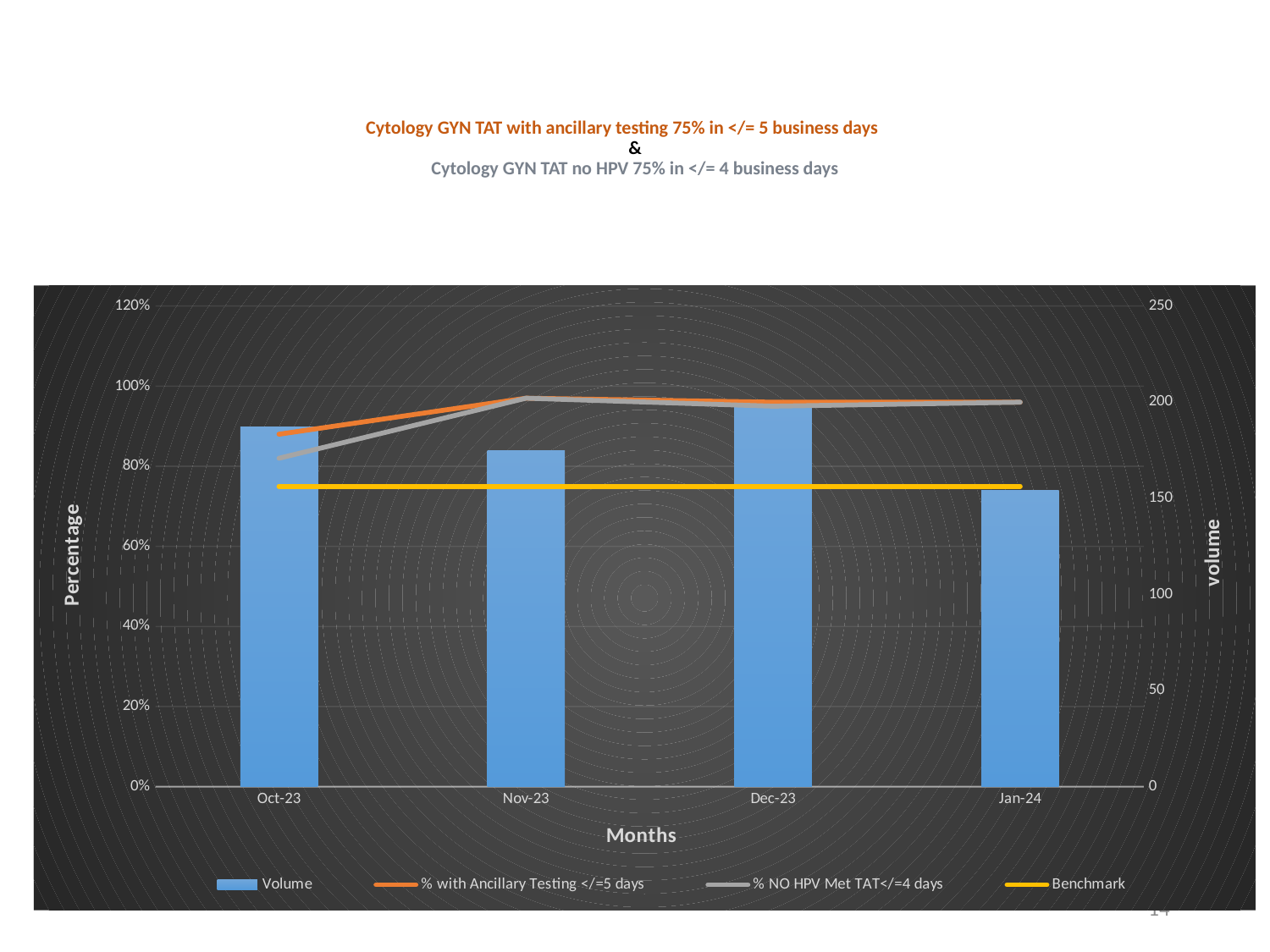
How many series does the legend list? 4 Is the Volume for Nov-23 greater or less than 150? greater What is the title of the x axis? Months Which is larger, the Volume for Oct-23 or the Volume for Nov-23? Oct-23 In Oct-23, which is higher: % with Ancillary Testing </=5 days or % NO HPV Met TAT</=4 days? % with Ancillary Testing </=5 days Is the Volume for Oct-23 greater or less than 150? greater Does the Benchmark line rise, fall or stay flat across the months? stay flat Which month has the lowest Volume bar? Jan-24 What kind of chart is shown on the slide? A combination bar and line chart Is the Volume for Jan-24 greater or less than 200? less How many months are shown on the x axis? 4 Which month has the highest Volume bar? Dec-23